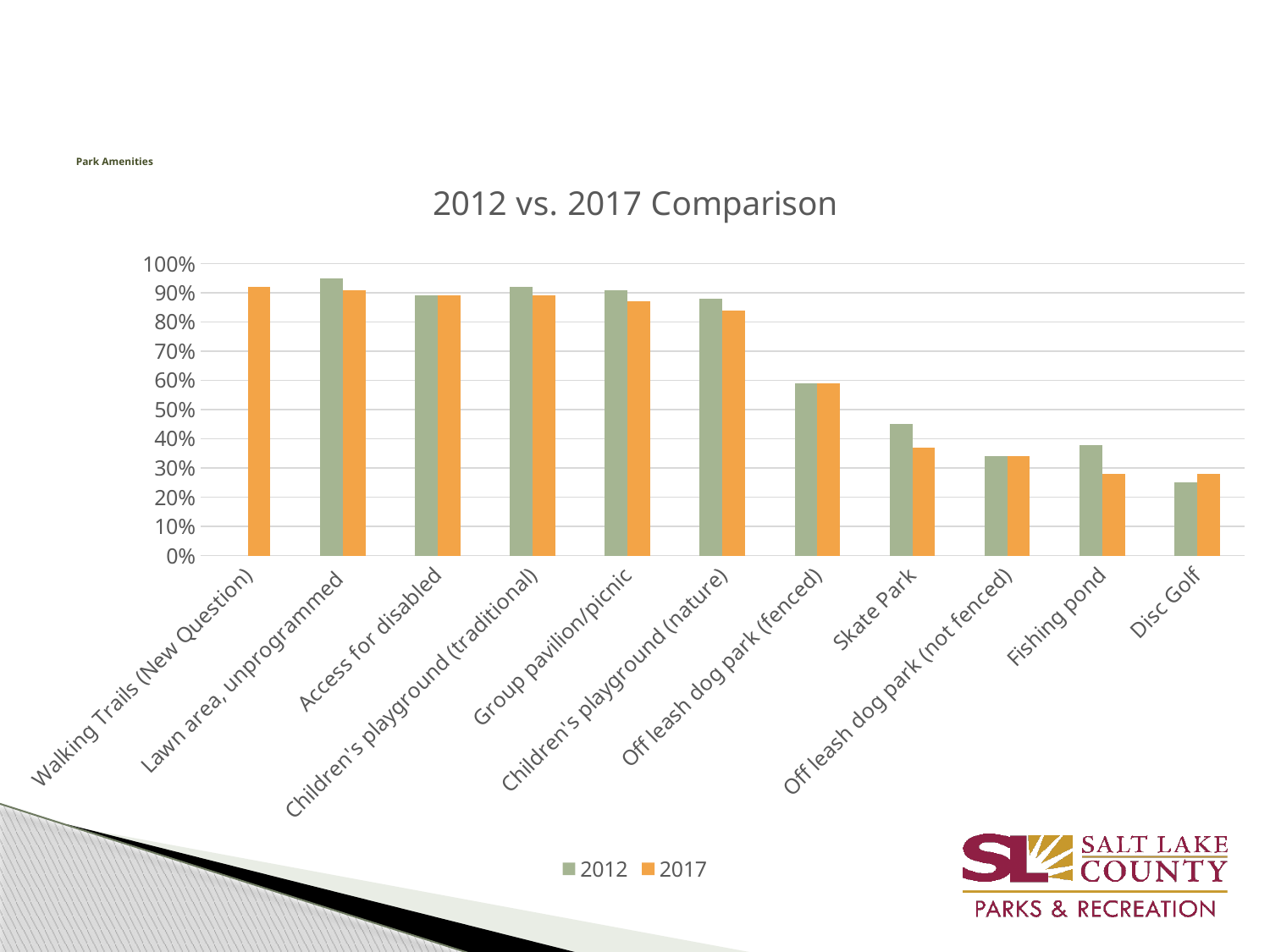
How many categories are shown on the x axis? 11 Which category has the lowest 2012 value? Disc Golf Which category has the highest 2012 value? Lawn area, unprogrammed What kind of chart is shown on the slide? bar chart For Fishing pond, which is larger: the 2012 value or the 2017 value? 2012 For Skate Park, which is larger: the 2012 value or the 2017 value? 2012 Do the values generally rise or fall moving from left to right along the x axis? fall Is the 2017 value for Walking Trails (New Question) greater or less than 90%? greater How many series does the legend list? 2 Is the 2017 value for Skate Park greater or less than 40%? less What is the title of the chart? 2012 vs. 2017 Comparison Is the 2012 value for Disc Golf greater or less than 30%? less